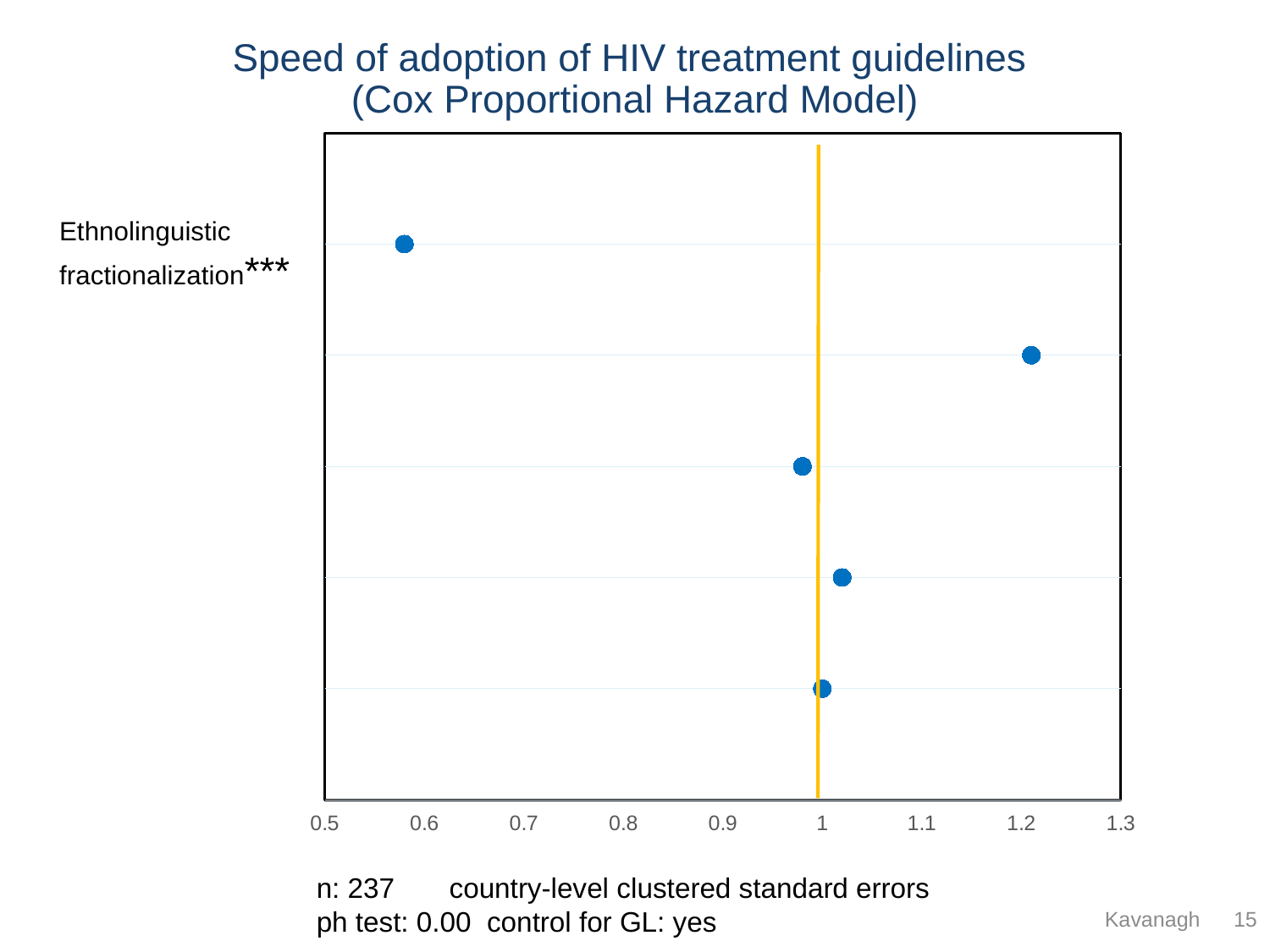
How many data points are plotted on the chart? 5 What is the lowest value shown on the x axis? 0.5 Is the value for Ethnolinguistic fractionalization greater or less than 1? less What kind of chart is shown on the slide? scatter plot At what x-axis value is the vertical reference line drawn? 1 Is the value for Ethnolinguistic fractionalization greater or less than 0.7? less Is the value for Ethnolinguistic fractionalization greater or less than 0.5? greater Which labelled category has the lowest plotted value on the chart? Ethnolinguistic fractionalization